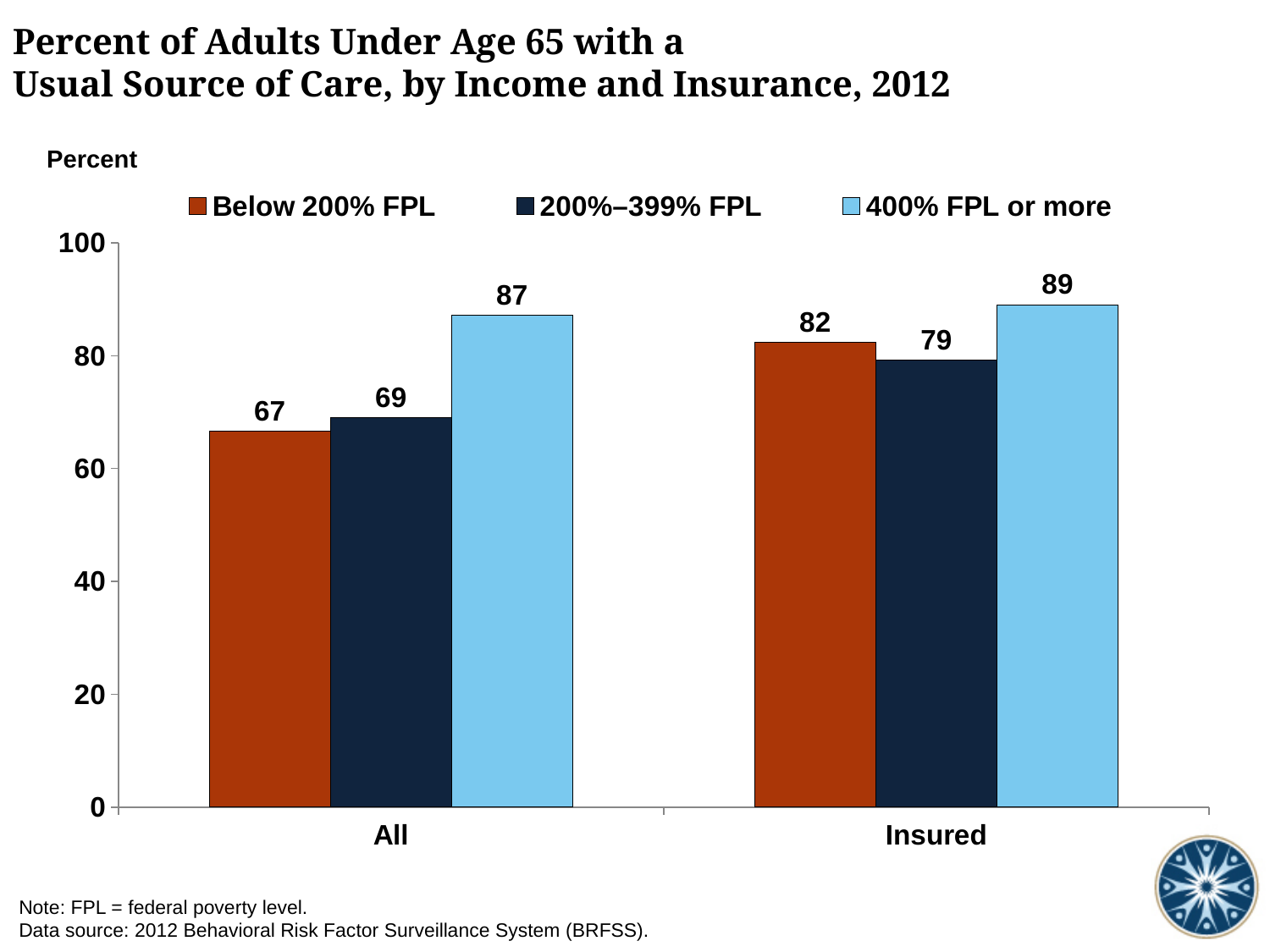
What is the value for Below 200% FPL in the All category? 67 What colour represents the 400% FPL or more series? Light blue How many categories are shown on the x axis? 2 How many series does the legend list? 3 What is the value for 400% FPL or more in the Insured category? 89 Which income group has the highest value in the All category? 400% FPL or more What is the value for 200%–399% FPL in the Insured category? 79 What is the difference between the 400% FPL or more value and the Below 200% FPL value in the All category? 20 Which income group has the lowest value in the Insured category? 200%–399% FPL What kind of chart is shown on the slide? Bar chart What is the difference between the Below 200% FPL values for Insured and All? 15 Which is larger: Below 200% FPL in the Insured category or 200%–399% FPL in the Insured category? Below 200% FPL in the Insured category